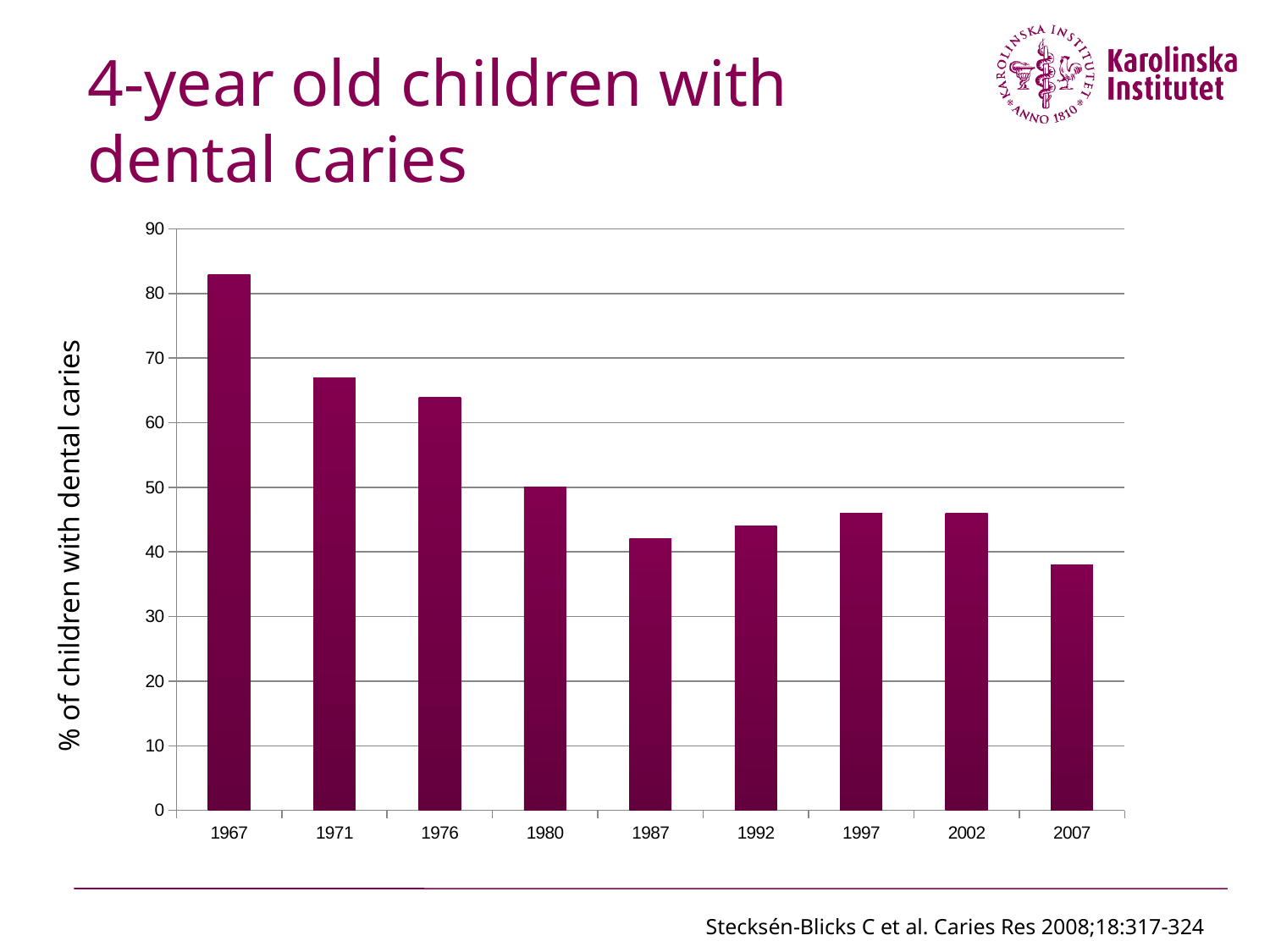
Which year has a higher value, 1987 or 1997? 1997 Overall, do the values rise or fall from 1967 to 2007? fall Is the value for 2007 greater or less than 40? less Which year has the highest percentage of children with dental caries? 1967 What is the label on the y axis of the chart? % of children with dental caries Is the value for 1992 greater or less than 50? less What kind of chart is shown on the slide? bar chart Which year has the lowest percentage of children with dental caries? 2007 Is the value for 1967 greater or less than 80? greater How many years are shown on the x axis of the chart? 9 Which year has a higher value, 1971 or 1976? 1971